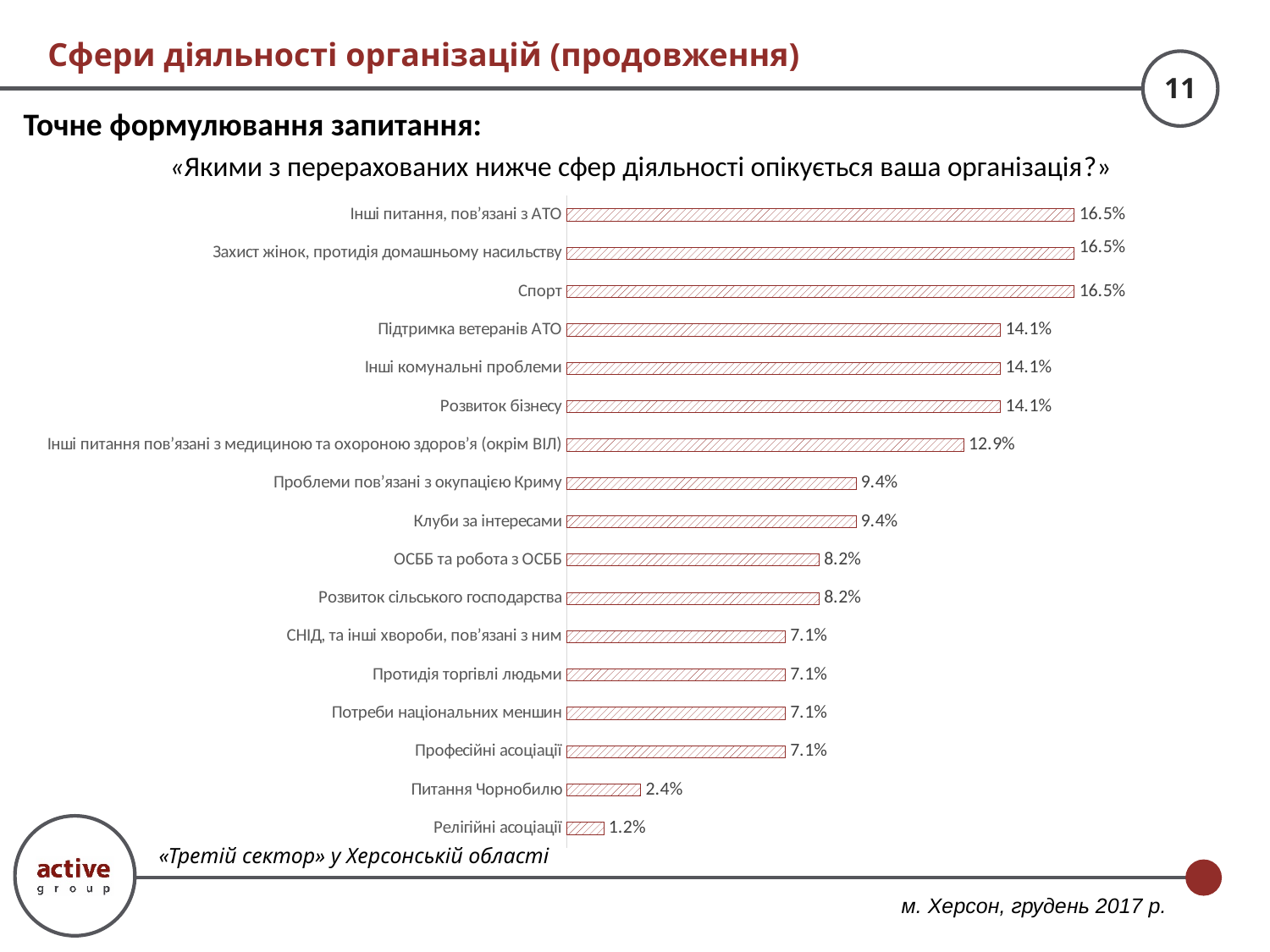
Which category has the lowest value? Релігійні асоціації What is the highest value shown on the chart? 16.5% What value is shown for Підтримка ветеранів АТО? 14.1% What value is shown for Питання Чорнобилю? 2.4% What value is shown for Клуби за інтересами? 9.4% What value is shown for Спорт? 16.5% What is the difference between the values for ОСББ та робота з ОСББ and Релігійні асоціації? 7.0% Which is larger, the value for Проблеми пов'язані з окупацією Криму or the value for Розвиток сільського господарства? Проблеми пов'язані з окупацією Криму What value is shown for Протидія торгівлі людьми? 7.1% What is the difference between the values for Спорт and Розвиток бізнесу? 2.4% What kind of chart is shown on the slide? Bar chart How many categories are shown on the chart? 17